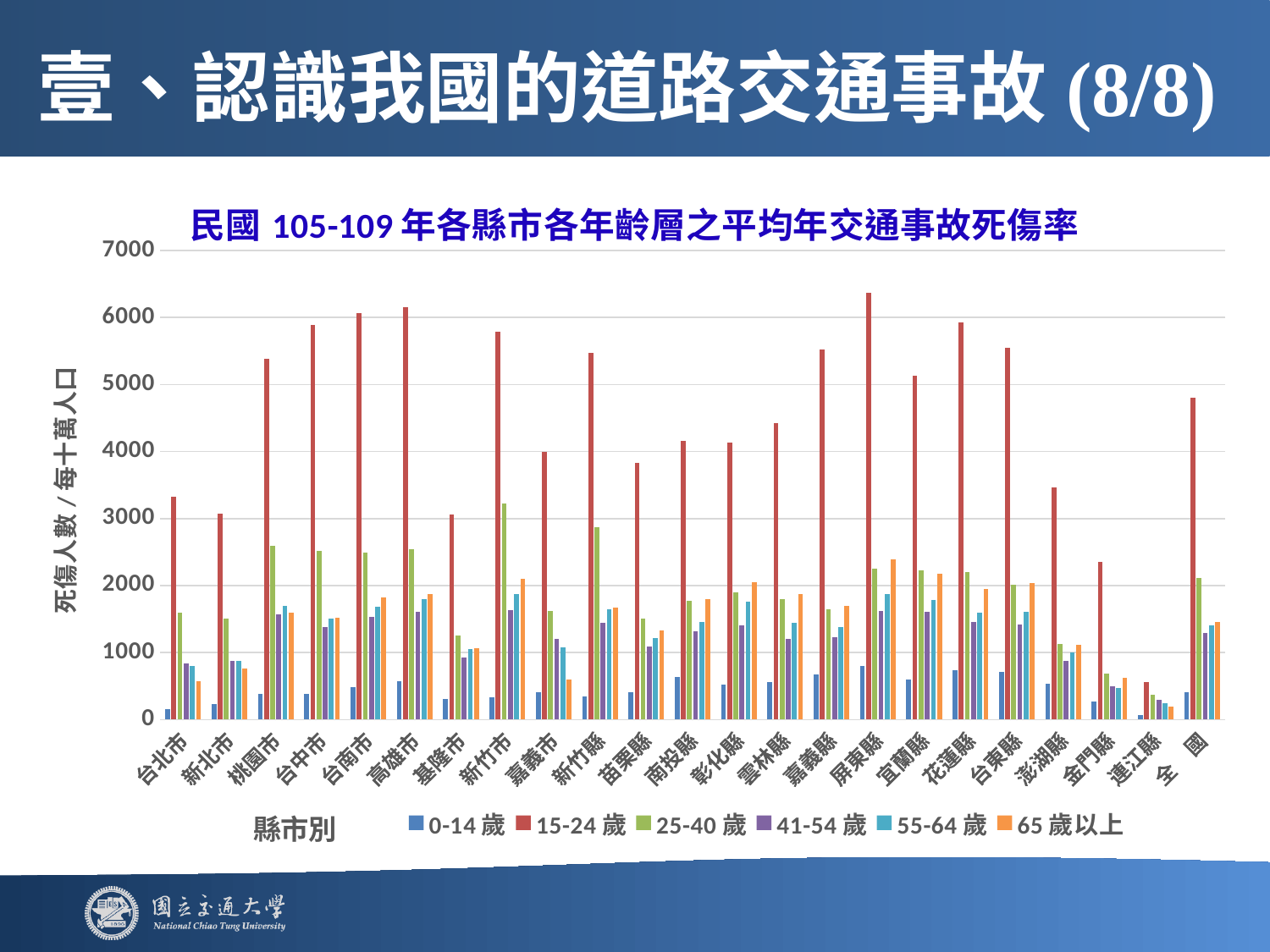
Which county or city has the lowest value for the 15-24 歲 series? 連江縣 Which county or city has the highest value for the 15-24 歲 series? 屏東縣 How many series does the legend list? 6 Is the 15-24 歲 value for 全國 greater or less than 4000? greater Is the 25-40 歲 value for 新竹市 greater or less than 3000? greater What is the title of the chart? 民國 105-109 年各縣市各年齡層之平均年交通事故死傷率 What kind of chart is shown on the slide? bar chart Is the 15-24 歲 value for 台北市 greater or less than 3000? greater Which has the larger 15-24 歲 value, 台中市 or 新北市? 台中市 How many categories (縣市) are shown along the x axis, including 全國? 23 Which age-group series has the tallest bar in every county or city? 15-24 歲